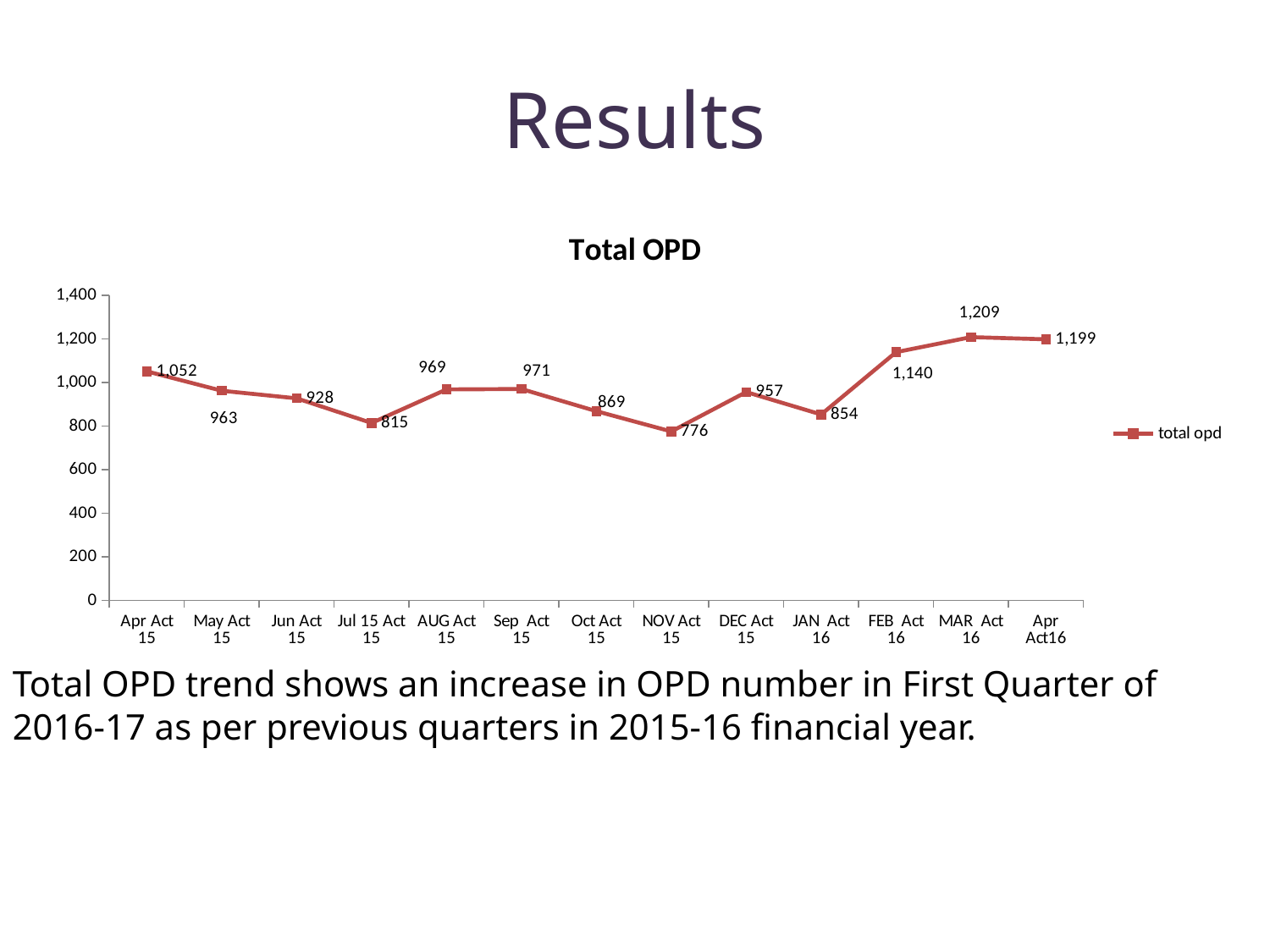
What kind of chart is shown on the slide? Line chart Which month has the highest total OPD? MAR Act 16 What is the title of the chart? Total OPD What is the difference between the total OPD for MAR Act 16 and NOV Act 15? 433 What is the total OPD value for MAR Act 16? 1,209 What is the total OPD value for Apr Act 15? 1,052 Which month has the lowest total OPD? NOV Act 15 What is the total OPD value for NOV Act 15? 776 Which is larger, the total OPD for Jul 15 Act 15 or JAN Act 16? JAN Act 16 Is the total OPD value for FEB Act 16 greater or less than 1,000? greater How many series does the legend list? 1 How many months are plotted on the chart? 13